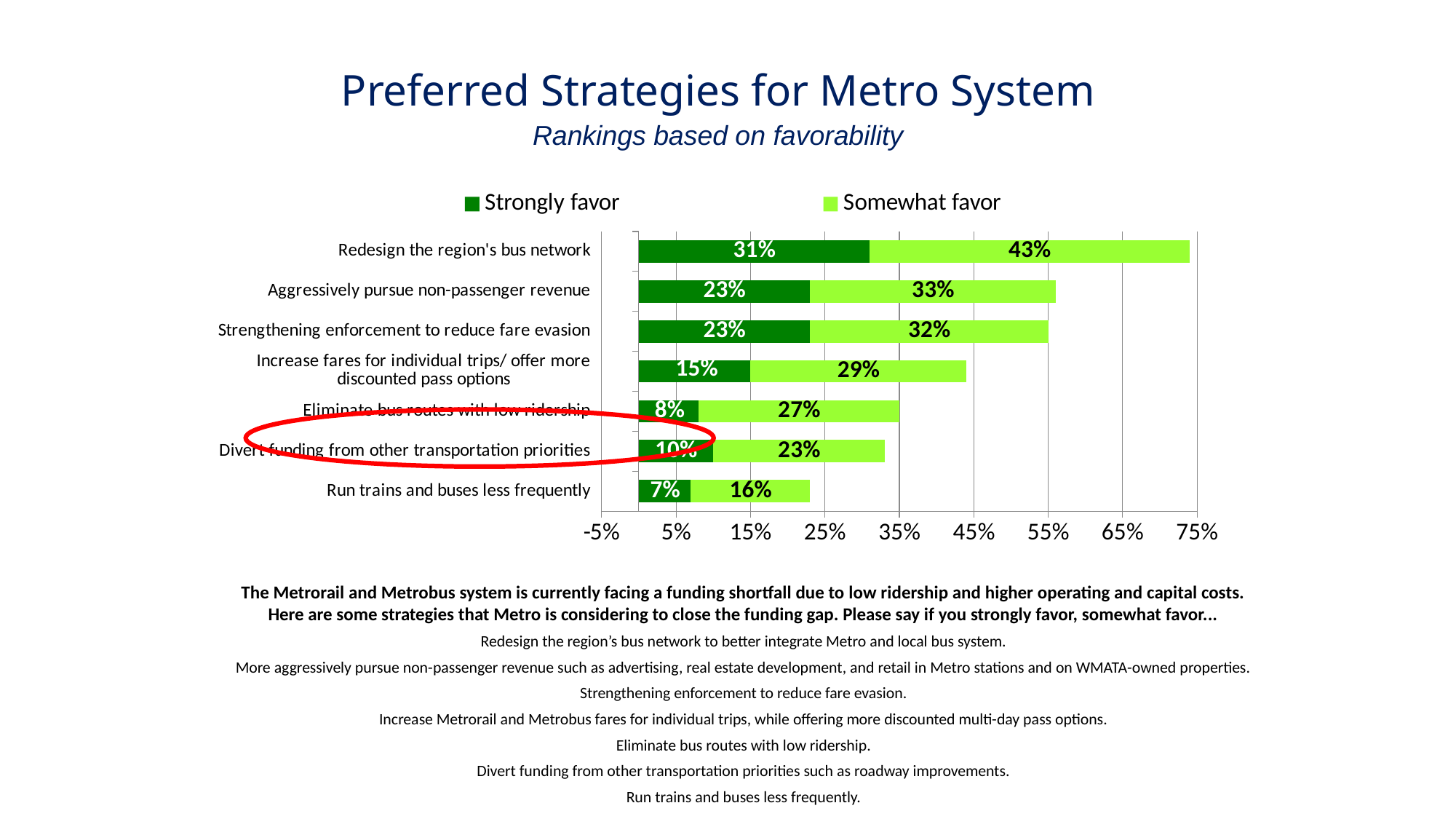
What is the difference between the Somewhat favor values for 'Redesign the region's bus network' and 'Strengthening enforcement to reduce fare evasion'? 11% What is the Strongly favor value for 'Redesign the region's bus network'? 31% How many series does the legend list? 2 How many strategies are plotted in the chart? 7 Which strategy has the lowest Somewhat favor value? Run trains and buses less frequently What is the Somewhat favor value for 'Eliminate bus routes with low ridership'? 27% Which is larger: the Strongly favor value for 'Increase fares for individual trips/ offer more discounted pass options' or for 'Eliminate bus routes with low ridership'? Increase fares for individual trips/ offer more discounted pass options What is the total of the stacked bar for 'Run trains and buses less frequently'? 23% Which strategy has the highest Strongly favor value? Redesign the region's bus network What kind of chart is shown on the slide? Stacked bar chart What is the Somewhat favor value for 'Aggressively pursue non-passenger revenue'? 33% What is the subtitle of the chart? Rankings based on favorability